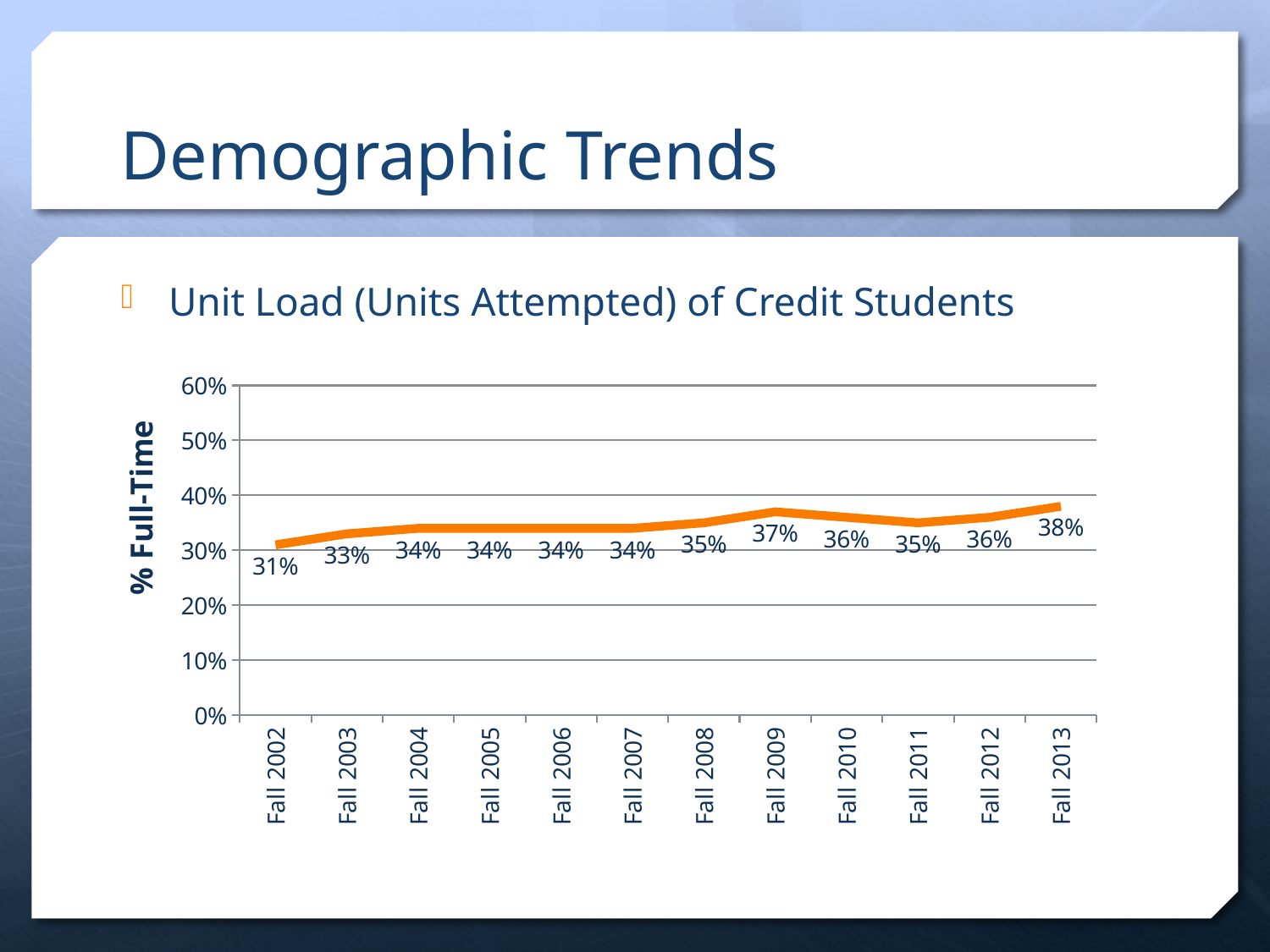
What is the difference between the % Full-Time values for Fall 2013 and Fall 2002? 7% What is the % Full-Time value for Fall 2011? 35% Which term has the lowest % Full-Time value? Fall 2002 Which term has the highest % Full-Time value? Fall 2013 What kind of chart is shown on the slide? line chart What is the % Full-Time value for Fall 2009? 37% Overall, do the % Full-Time values rise or fall from Fall 2002 to Fall 2013? rise What is the % Full-Time value for Fall 2013? 38% How many terms are plotted on the x axis? 12 What is the % Full-Time value for Fall 2002? 31% Is the value for Fall 2013 greater or less than 50%? less Which is larger, the % Full-Time value for Fall 2009 or for Fall 2010? Fall 2009